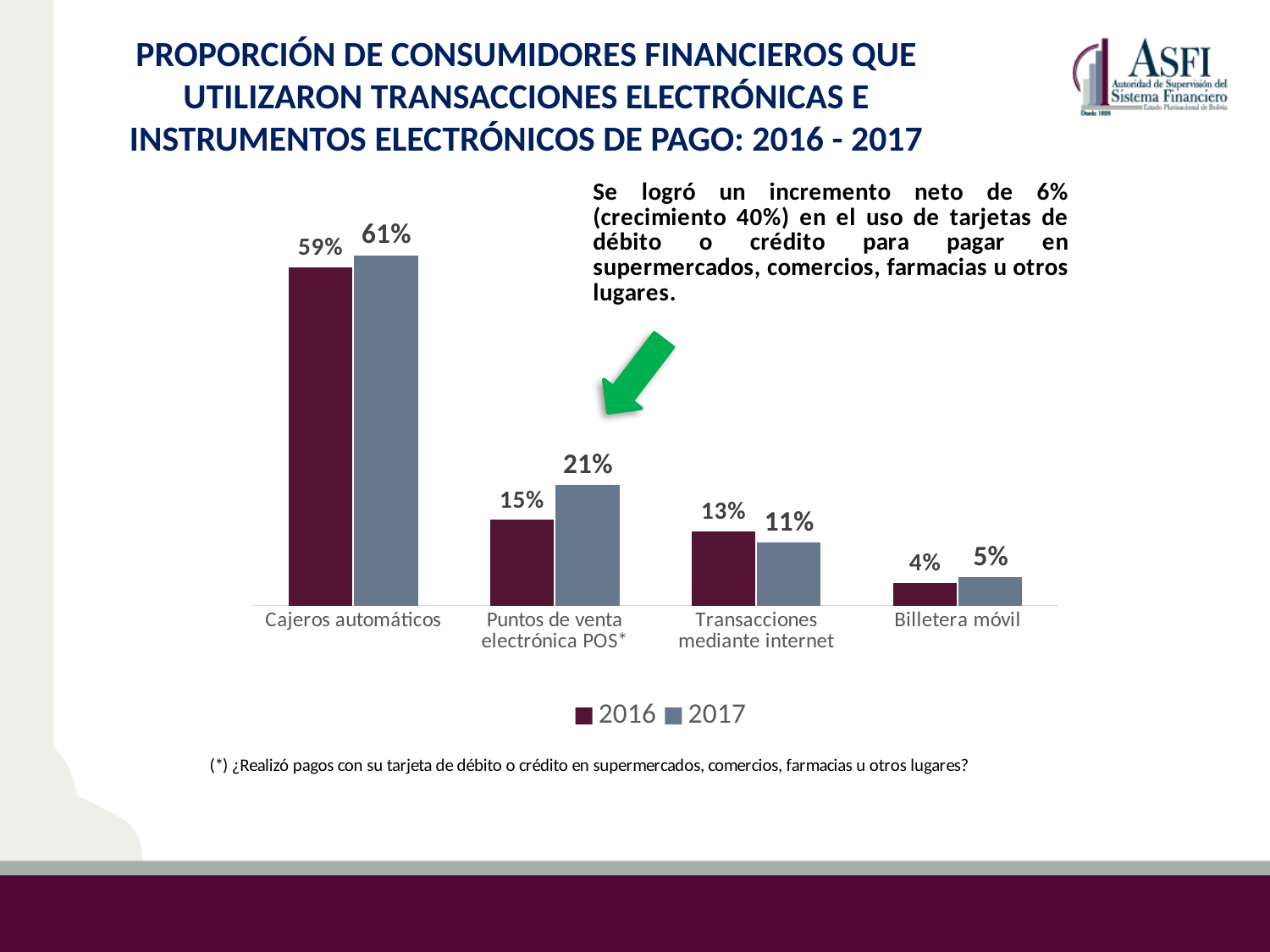
What is the value for Cajeros automáticos in 2017? 61% What is the value for Billetera móvil in 2016? 4% Which is larger for Transacciones mediante internet: the 2016 value or the 2017 value? 2016 What is the value for Transacciones mediante internet in 2017? 11% Which category has the highest value in 2017? Cajeros automáticos How many series does the legend list? 2 What is the difference between the 2017 and 2016 values for Puntos de venta electrónica POS*? 6% What kind of chart is shown on the slide? Bar chart Which category has the lowest value in 2016? Billetera móvil How many categories are shown on the x axis? 4 Which series is shown in dark red in the legend? 2016 What is the value for Puntos de venta electrónica POS* in 2016? 15%